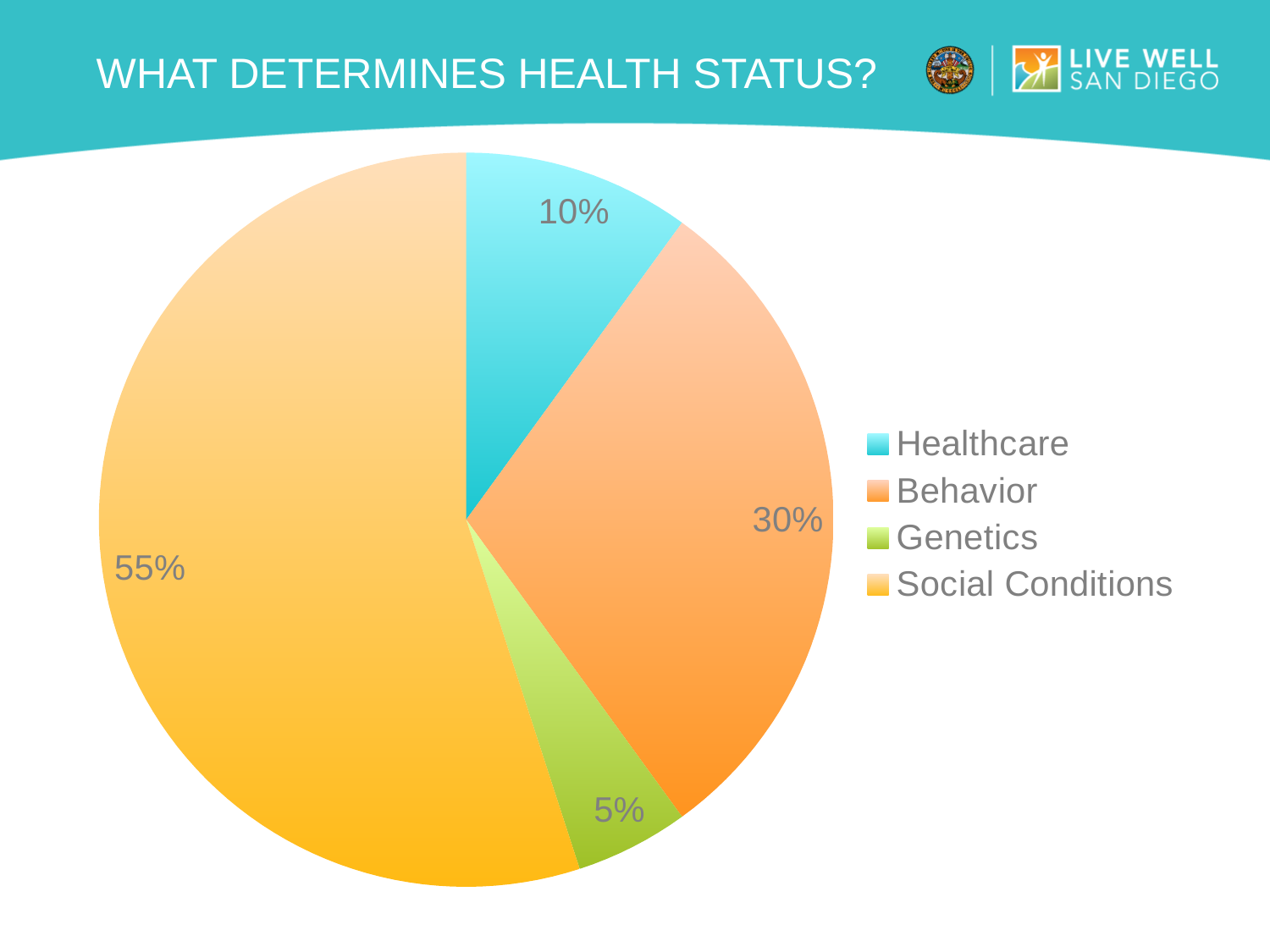
What is the difference between the Social Conditions and Behavior values? 25% What is the value shown for Behavior? 30% What is the value shown for Healthcare? 10% Which category is shown in green in the legend? Genetics Which category has the largest slice of the pie? Social Conditions How many categories does the pie chart have? 4 What kind of chart is shown on the slide? pie chart What share of the pie does Social Conditions account for? 55% What is the value shown for Genetics? 5% What is the title of the slide containing the chart? WHAT DETERMINES HEALTH STATUS? Which is larger, Healthcare or Behavior? Behavior Which category has the smallest slice of the pie? Genetics